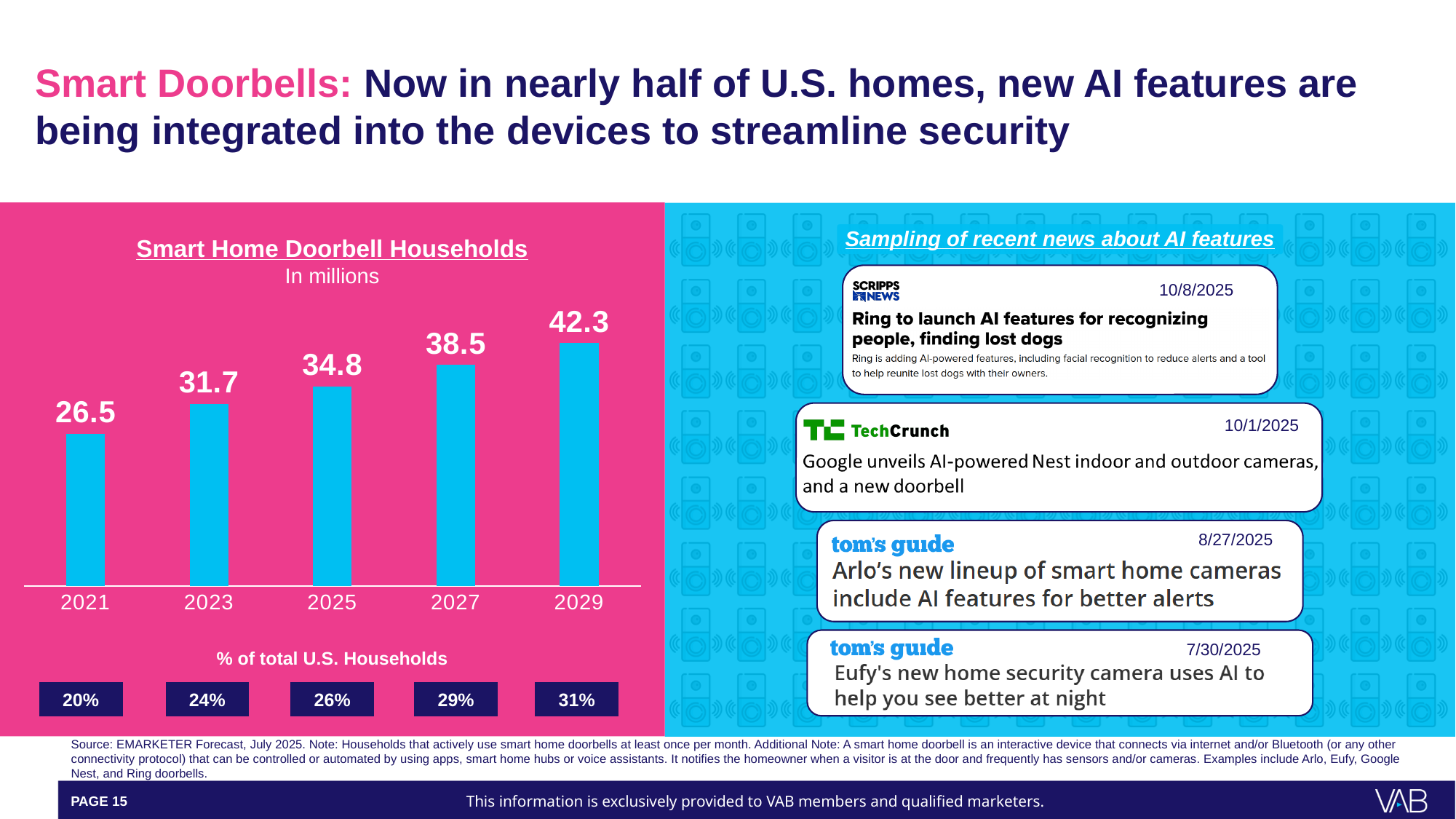
What is the difference between the 2027 and 2023 values in the Smart Home Doorbell Households chart? 6.8 What unit is stated under the title of the Smart Home Doorbell Households chart? In millions What kind of chart is the Smart Home Doorbell Households chart? Bar chart Which year has the lowest value in the Smart Home Doorbell Households chart? 2021 Which is larger in the Smart Home Doorbell Households chart, the value for 2023 or the value for 2027? 2027 Which year has the highest value in the Smart Home Doorbell Households chart? 2029 What is the value for 2025 in the Smart Home Doorbell Households chart? 34.8 Do the values in the Smart Home Doorbell Households chart rise or fall from 2021 to 2029? Rise How many years are shown in the Smart Home Doorbell Households chart? 5 What is the value for 2021 in the Smart Home Doorbell Households chart? 26.5 What is the difference between the 2029 and 2021 values in the Smart Home Doorbell Households chart? 15.8 What is the value for 2029 in the Smart Home Doorbell Households chart? 42.3